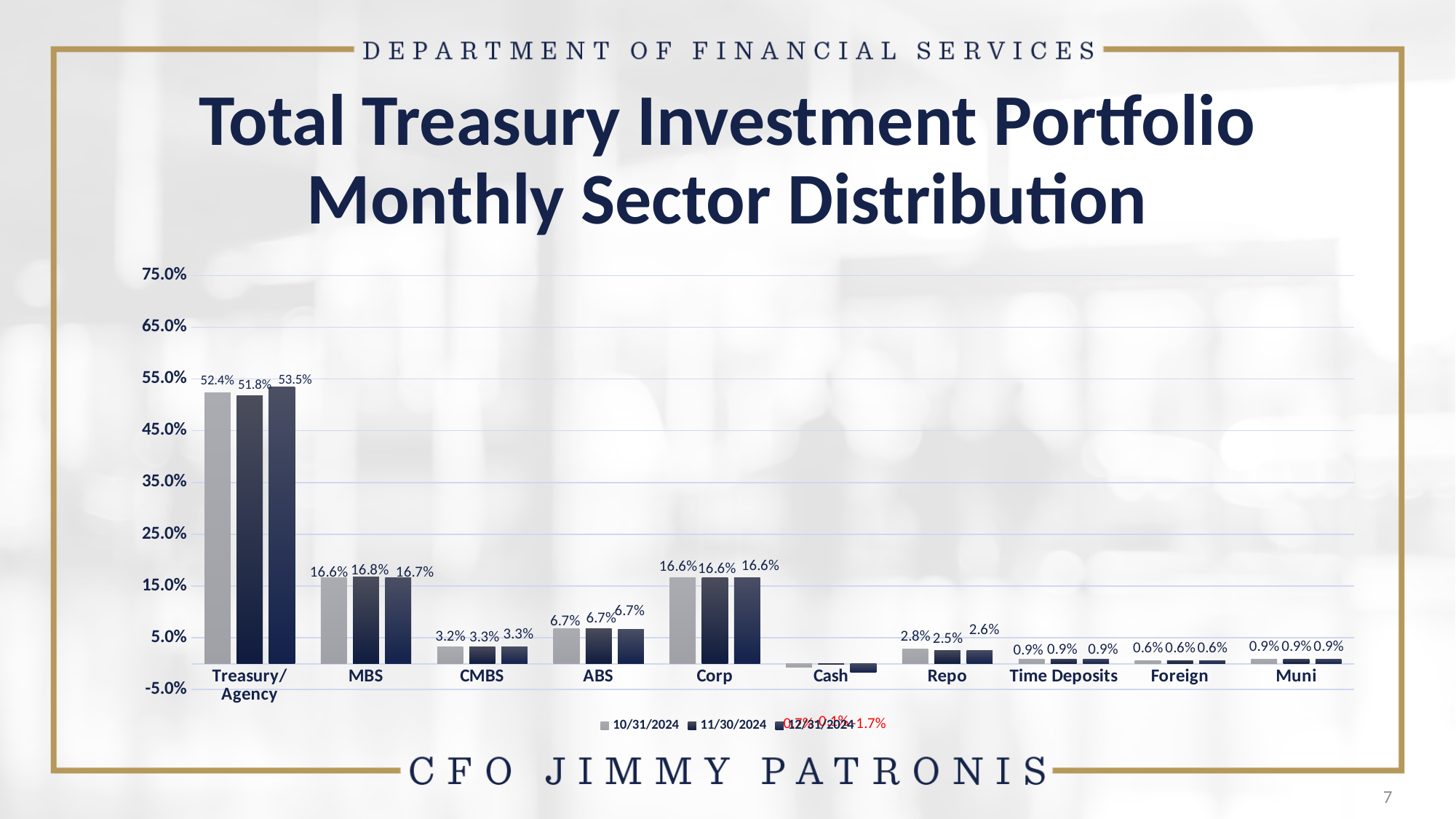
Is the value for Treasury/Agency for 10/31/2024 greater or less than 45.0%? greater What is the value for Treasury/Agency for 12/31/2024? 53.5% What is the value for Repo for 10/31/2024? 2.8% What is the difference between the Treasury/Agency values for 12/31/2024 and 10/31/2024? 1.1% What is the value for MBS for 11/30/2024? 16.8% How many sector categories are shown on the x axis? 10 Which is larger for 11/30/2024: the value for Corp or the value for ABS? Corp How many series does the legend list? 3 What is the value for CMBS for 10/31/2024? 3.2% What type of chart is shown on the slide? Bar chart Which sector has the highest value for 12/31/2024? Treasury/Agency Which sector has the lowest value for 12/31/2024? Cash